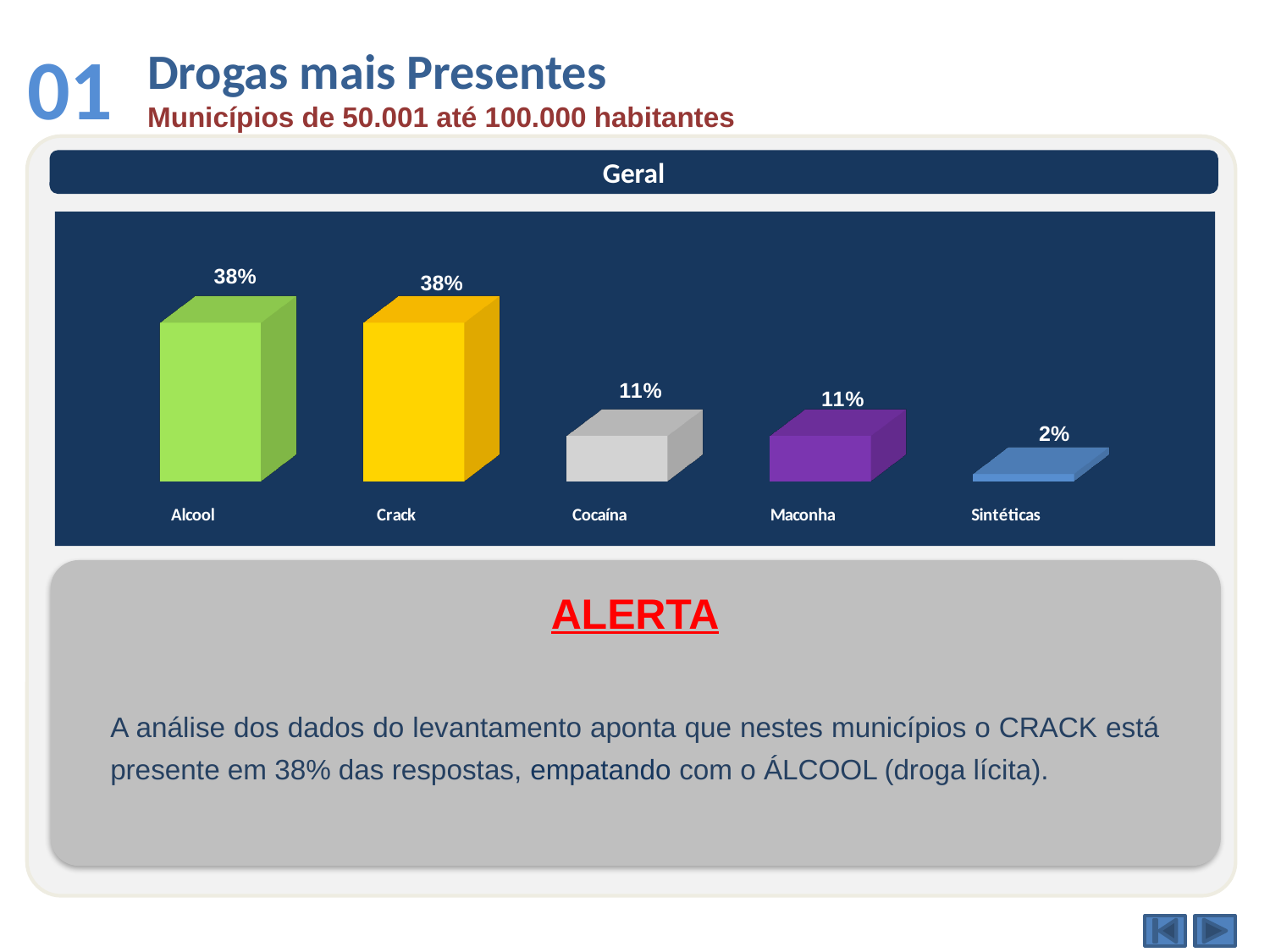
What is the value for Alcool? 38% What is the difference between the values for Maconha and Sintéticas? 9% How many categories are shown in the chart? 5 What is the difference between the values for Crack and Cocaína? 27% Which is larger, the value for Alcool or the value for Maconha? Alcool What is the value for Maconha? 11% What is the value for Sintéticas? 2% What kind of chart is shown on the slide? Bar chart Which category has the lowest value? Sintéticas What is the value for Cocaína? 11% What is the title shown above the chart? Geral What is the value for Crack? 38%